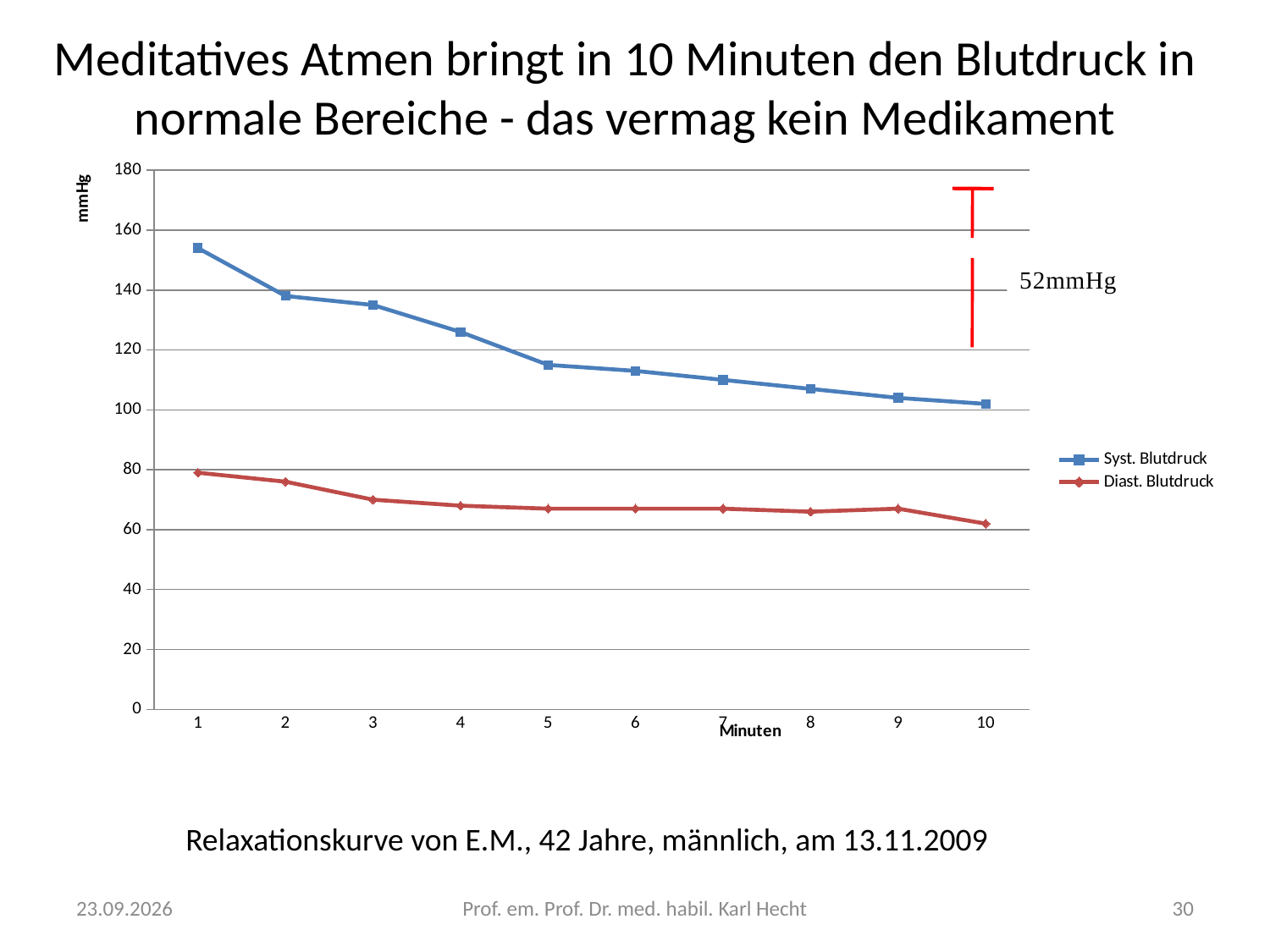
Is the Diast. Blutdruck value at minute 5 greater or less than 80? less At which minute is the Syst. Blutdruck value lowest? 10 What is the label on the y axis of the chart? mmHg Is the Syst. Blutdruck value at minute 1 greater or less than 140? greater Which is larger at minute 5: the Syst. Blutdruck value or the Diast. Blutdruck value? Syst. Blutdruck Does the Syst. Blutdruck series rise or fall from minute 1 to minute 10? fall How many series does the legend list? 2 What kind of chart is shown on the slide? line chart What value is written next to the red annotation bar on the right of the chart? 52mmHg How many points are plotted along the x axis for each series? 10 At which minute is the Syst. Blutdruck value highest? 1 Is the Syst. Blutdruck value at minute 5 greater or less than 120? less